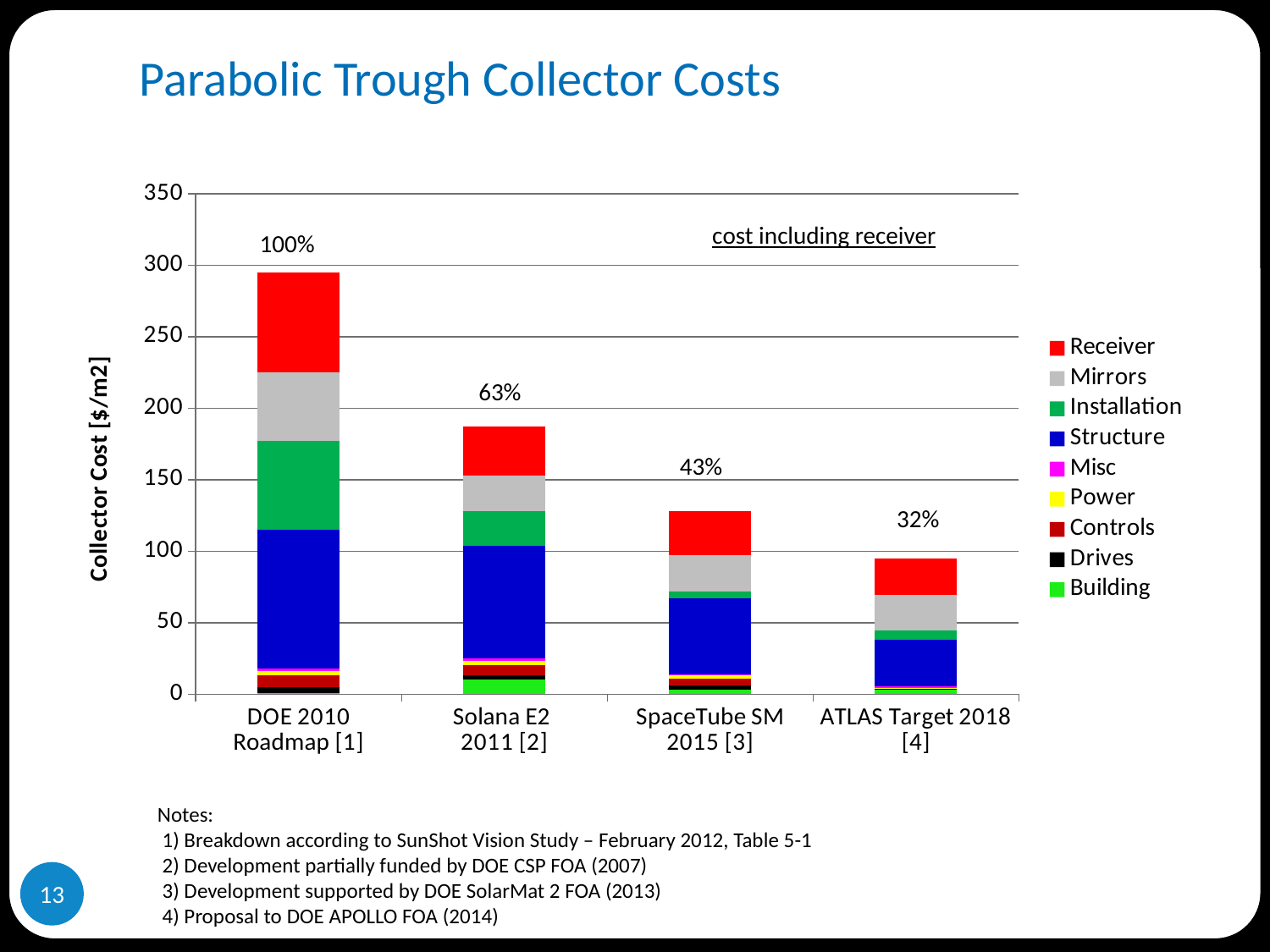
What percentage label is printed above the SpaceTube SM 2015 [3] bar? 43% What kind of chart is shown on the slide? bar chart Do the total collector costs rise or fall from left to right along the x axis? fall Which category has the lowest total collector cost? ATLAS Target 2018 [4] What percentage label is printed above the ATLAS Target 2018 [4] bar? 32% How many series does the legend list? 9 Which category has the highest total collector cost? DOE 2010 Roadmap [1] What percentage label is printed above the Solana E2 2011 [2] bar? 63% How many categories (bars) are shown on the x axis? 4 What percentage label is printed above the DOE 2010 Roadmap [1] bar? 100% Is the total collector cost for DOE 2010 Roadmap [1] greater or less than 250? greater What is the title of the y axis? Collector Cost [$/m2]